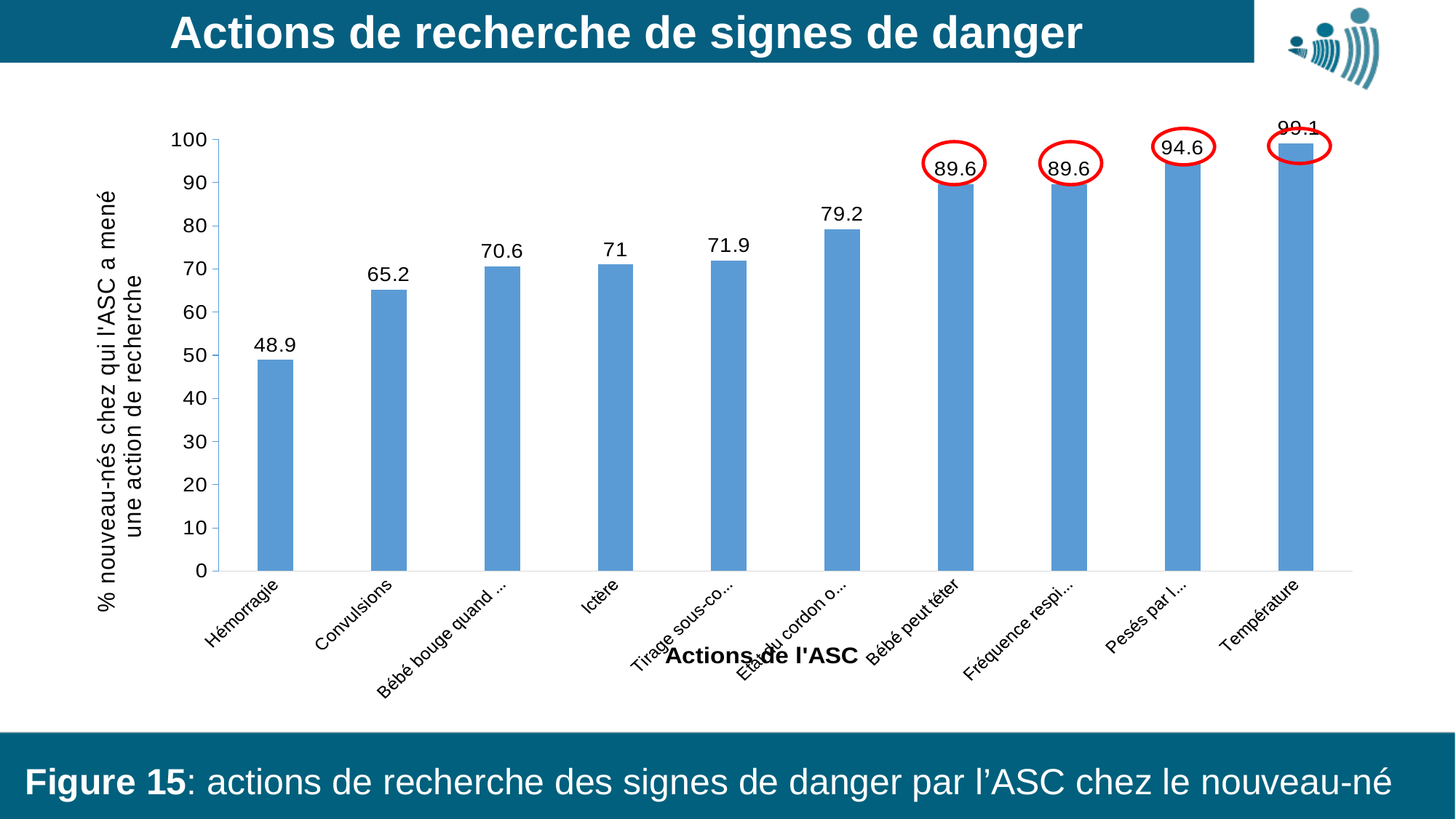
Do the values rise or fall from left to right along the x axis? rise Which is larger, the value for Convulsions or the value for Ictère? Ictère How many categories are shown on the x axis? 10 What is the value for Bébé peut téter? 89.6 What is the difference between the values for Bébé peut téter and Hémorragie? 40.7 Is the value for Température greater or less than 90? greater Which category has the highest value? Température What type of chart is shown on the slide? bar chart Which category has the lowest value? Hémorragie What is the value for Convulsions? 65.2 What is the value for Hémorragie? 48.9 What is the value for Ictère? 71